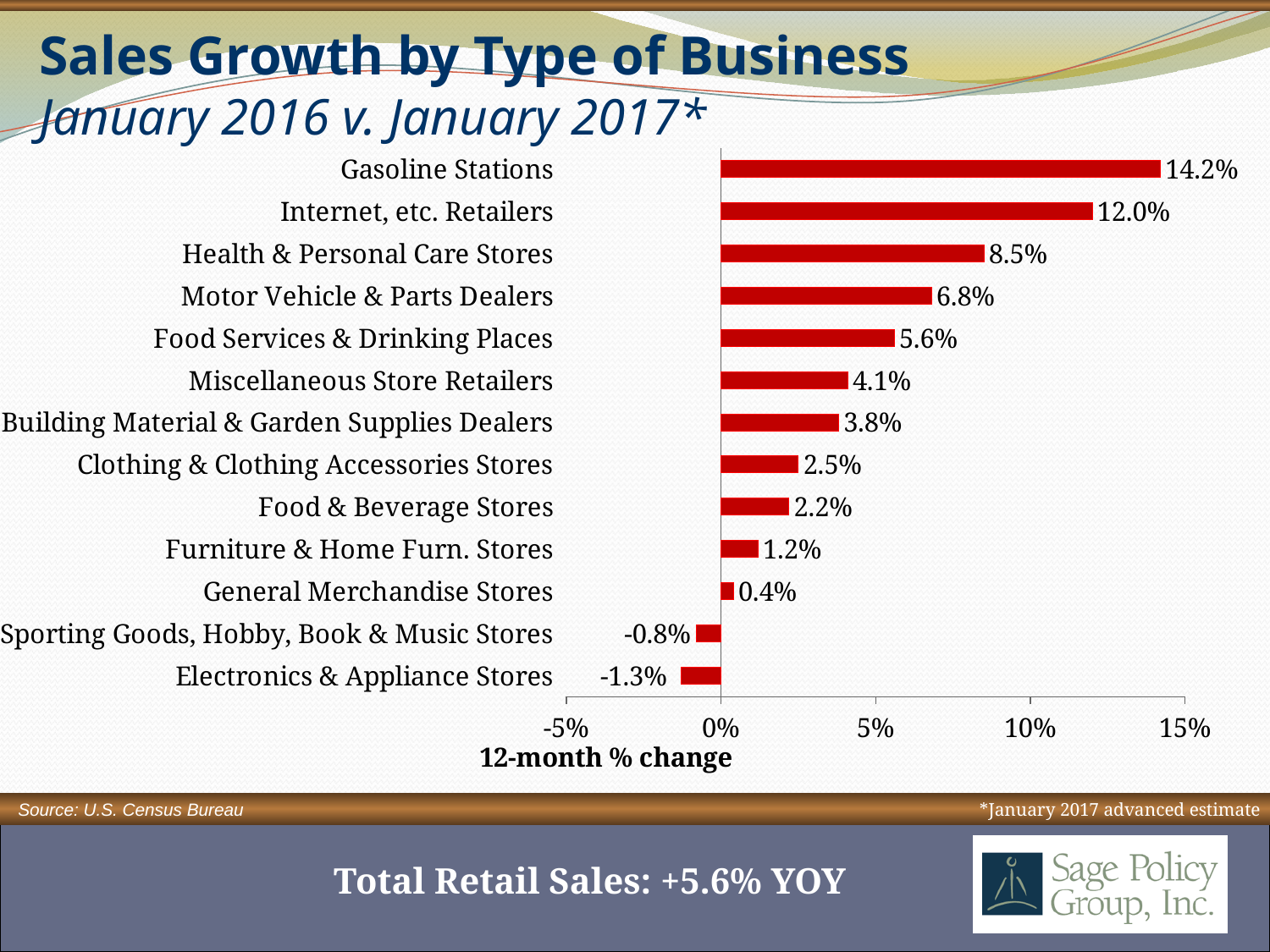
Which type of business has the highest 12-month % change? Gasoline Stations Which has a larger 12-month % change, Health & Personal Care Stores or Motor Vehicle & Parts Dealers? Health & Personal Care Stores How many types of business are shown in the chart? 13 What is the 12-month % change for Electronics & Appliance Stores? -1.3% What is the 12-month % change for Food & Beverage Stores? 2.2% What is the 12-month % change for Gasoline Stations? 14.2% Which type of business has the lowest 12-month % change? Electronics & Appliance Stores Is the value for Internet, etc. Retailers greater or less than 10%? greater How many types of business show a negative 12-month % change? 2 What is the difference between the 12-month % change for Gasoline Stations and Internet, etc. Retailers? 2.2% What kind of chart is shown on the slide? Bar chart What is the label on the horizontal axis of the chart? 12-month % change